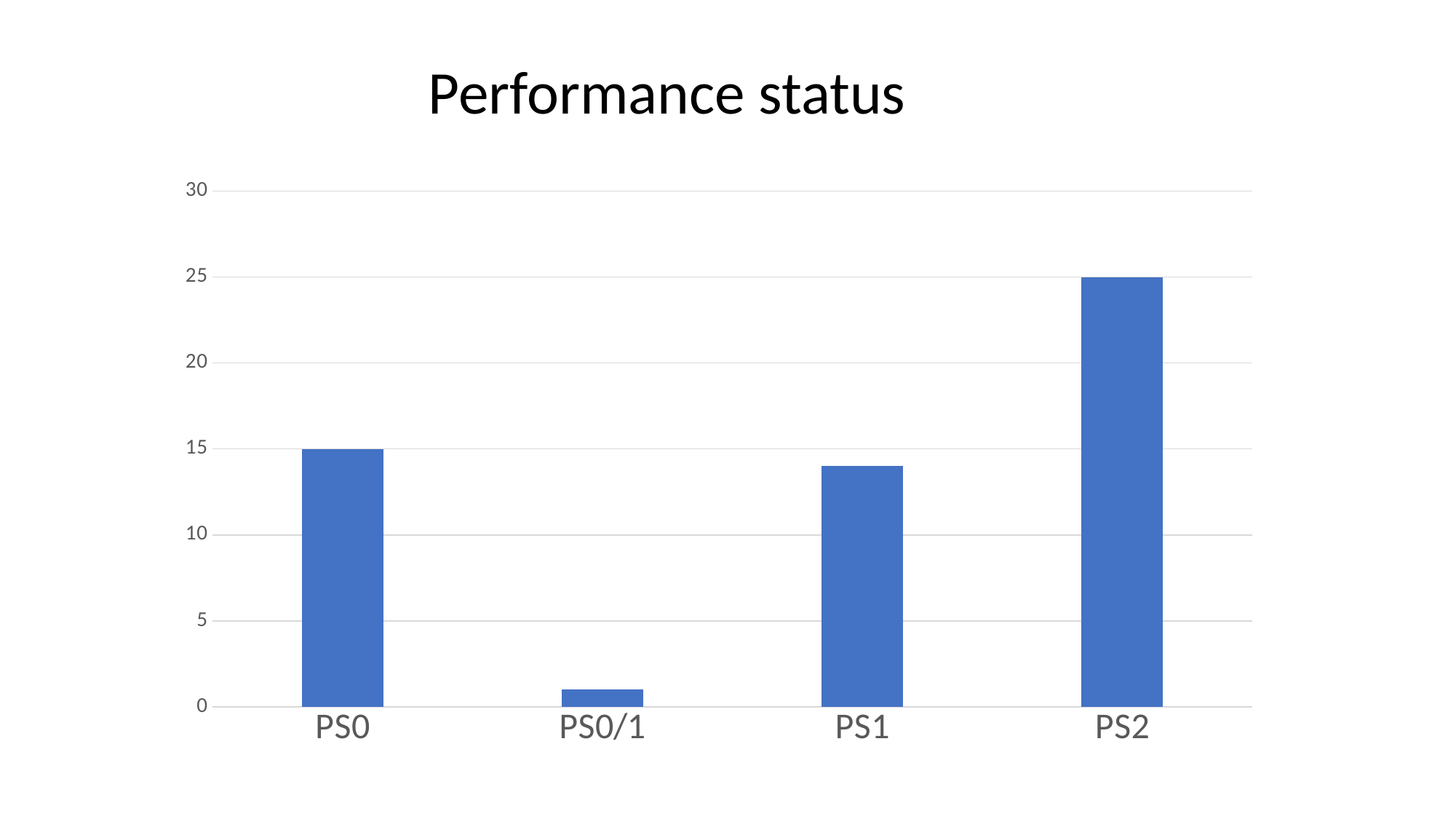
What is the difference between the values for PS2 and PS0? 10 Which is larger, the value for PS2 or the value for PS0? PS2 Which category has the lowest value? PS0/1 What is the value for PS2? 25 What is the value for PS0? 15 Is the value for PS0/1 greater or less than 5? less How many categories are shown on the x axis of the chart? 4 What type of chart is shown on the slide? Bar chart Is the value for PS1 greater or less than 10? greater What is the title of the chart? Performance status Which category has the highest value? PS2 Which is larger, the value for PS0 or the value for PS0/1? PS0